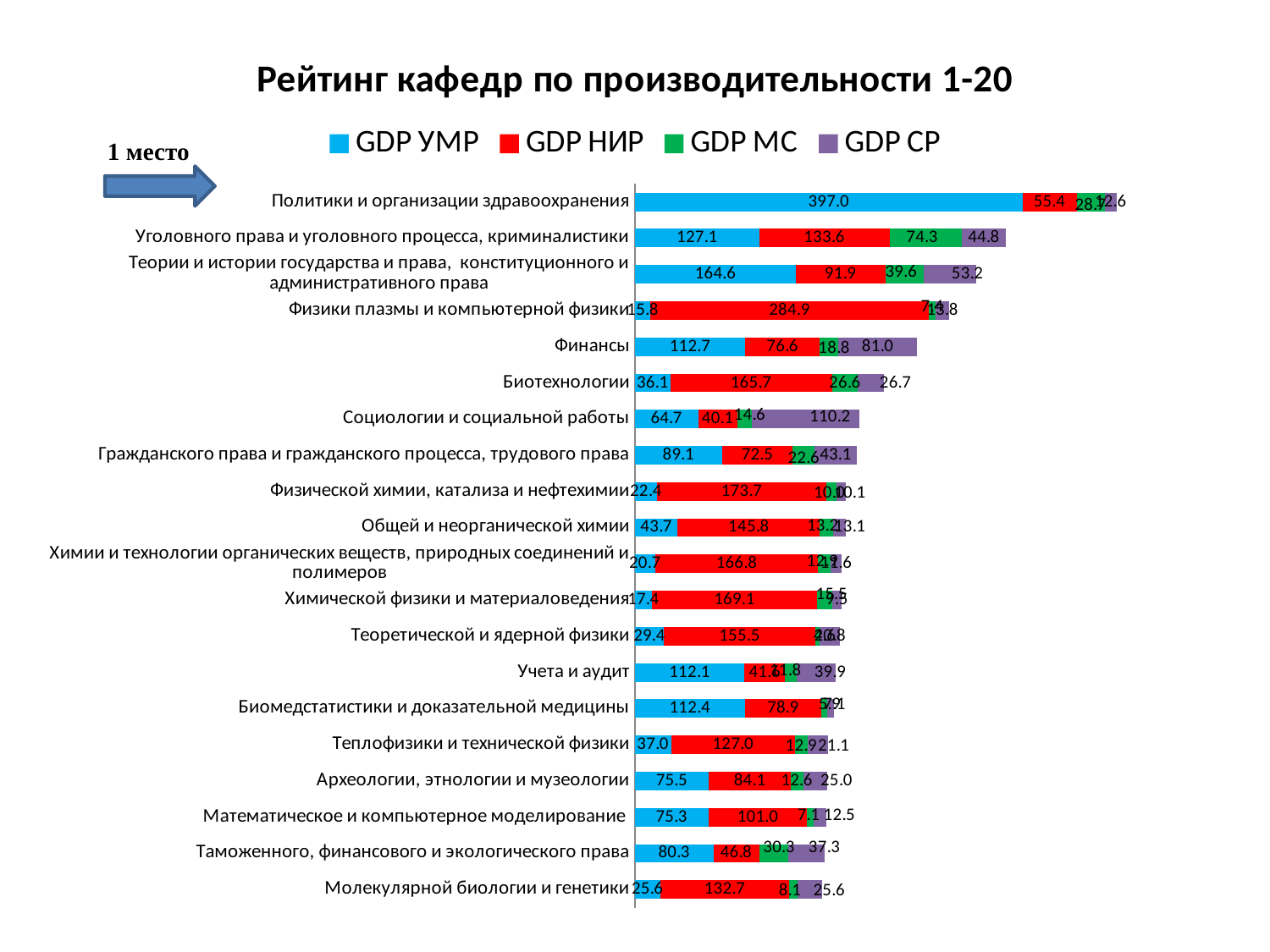
Which department has the highest GDP УМР value? Политики и организации здравоохранения What kind of chart is shown on the slide? Stacked bar chart What is the GDP МС value for Таможенного, финансового и экологического права? 30.3 What is the GDP СР value for Социологии и социальной работы? 110.2 What colour represents GDP НИР in the chart? Red What is the total of the stacked bar for Уголовного права и уголовного процесса, криминалистики? 379.8 How many series does the legend list? 4 For Финансы, what is the difference between the GDP УМР value and the GDP НИР value? 36.1 How many departments (categories) are plotted in the chart? 20 What is the GDP НИР value for Физики плазмы и компьютерной физики? 284.9 What is the GDP УМР value for Политики и организации здравоохранения? 397.0 For Археологии, этнологии и музеологии, which is larger: GDP УМР or GDP НИР? GDP НИР